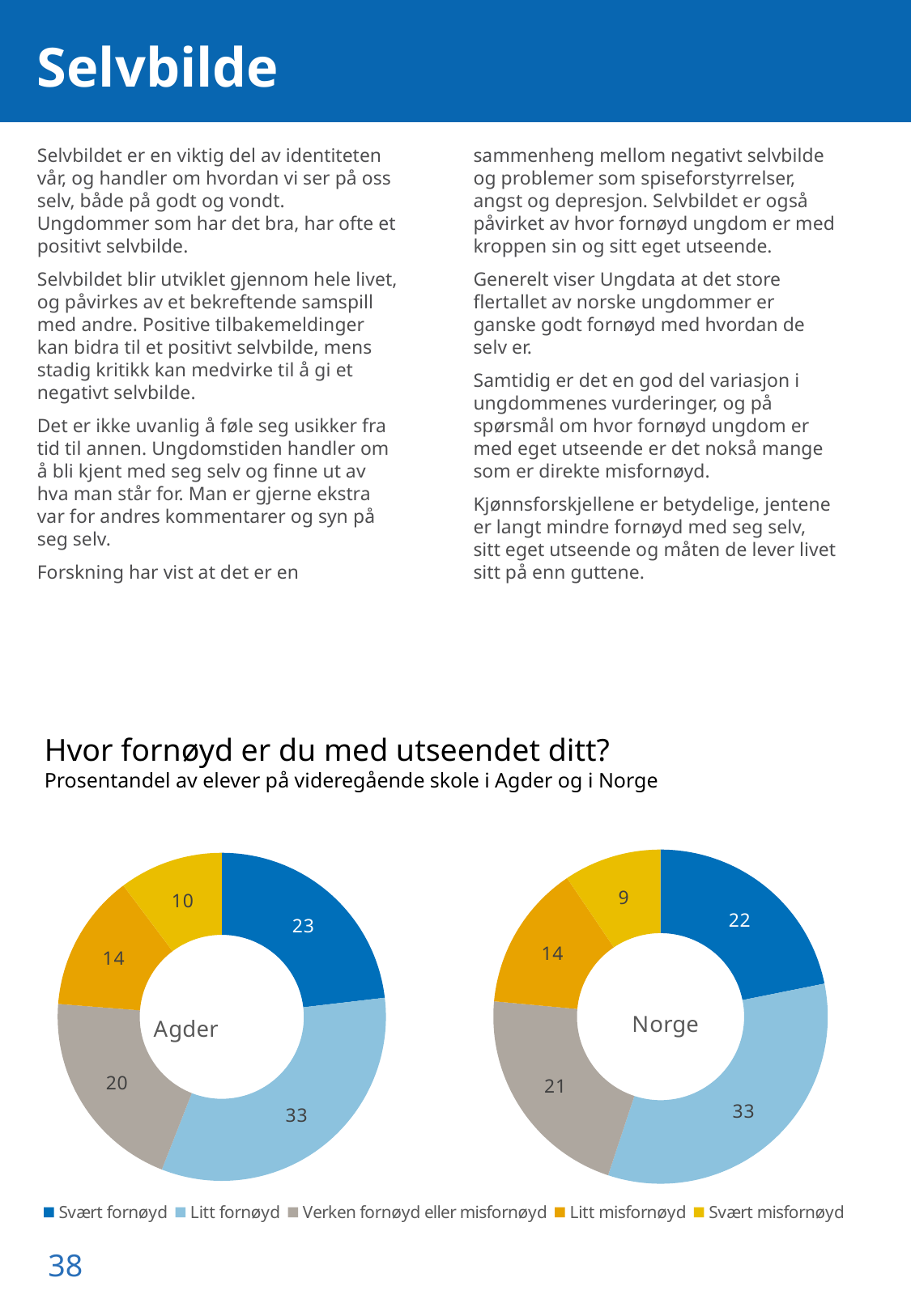
What is the title of the chart section on the slide? Hvor fornøyd er du med utseendet ditt? How many categories does each donut chart show? 5 Which colour represents Litt misfornøyd in the legend? Orange In the Agder chart, what is the difference between Litt fornøyd and Svært fornøyd? 10 In the Norge chart, which category has the smallest share? Svært misfornøyd In the Norge chart, what is the value for Svært misfornøyd? 9 In the Norge chart, what is the value for Svært fornøyd? 22 In the Agder chart, which category has the largest share? Litt fornøyd What kind of charts are shown on the slide? Donut (pie) charts Which is larger: Svært misfornøyd in Agder or Svært misfornøyd in Norge? Agder In the Agder chart, what is the value for Verken fornøyd eller misfornøyd? 20 In the Agder chart, what is the value for Litt fornøyd? 33